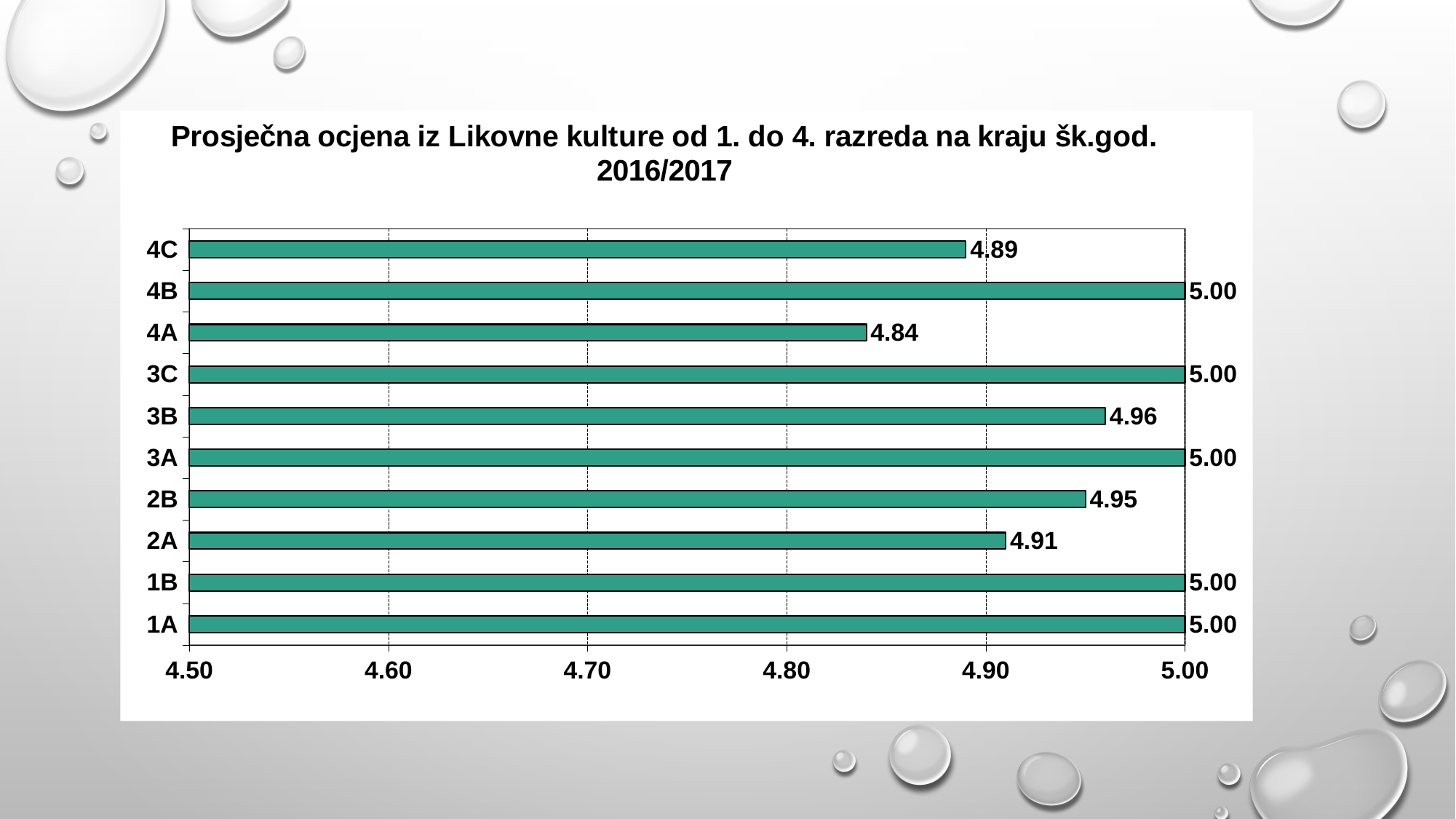
What is the average grade for class 2B? 4.95 Which class has the lowest average grade? 4A Is the value for 4A greater or less than 4.90? less How many classes have an average grade of 5.00? 5 What kind of chart is shown on the slide? Bar chart How many classes are shown in the chart? 10 What is the difference between the average grades of 4B and 4C? 0.11 What is the average grade for class 4A? 4.84 What is the average grade for class 4C? 4.89 What is the average grade for class 3B? 4.96 What is the difference between the average grades of 3B and 4A? 0.12 Which has a higher average grade, 2A or 2B? 2B